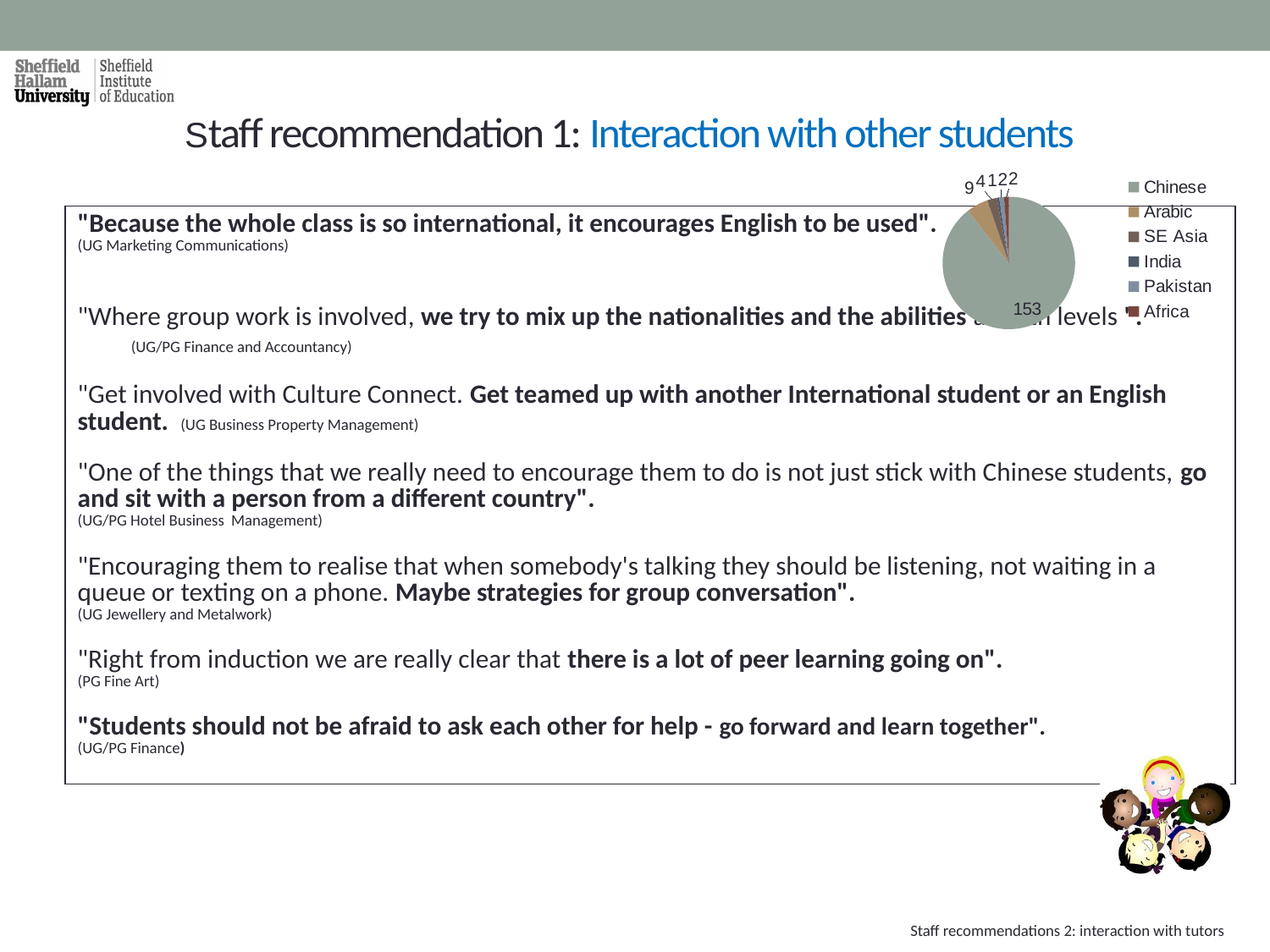
How many categories does the pie chart's legend list? 6 Which is larger in the pie chart, the Chinese slice or the Africa slice? Chinese Which category has the largest slice in the pie chart? Chinese Which is larger in the pie chart, the Chinese slice or the Arabic slice? Chinese What value is shown for the Chinese slice of the pie chart? 153 Which category is listed last in the pie chart's legend? Africa Which category is listed first in the pie chart's legend? Chinese What kind of chart is shown on the slide? Pie chart